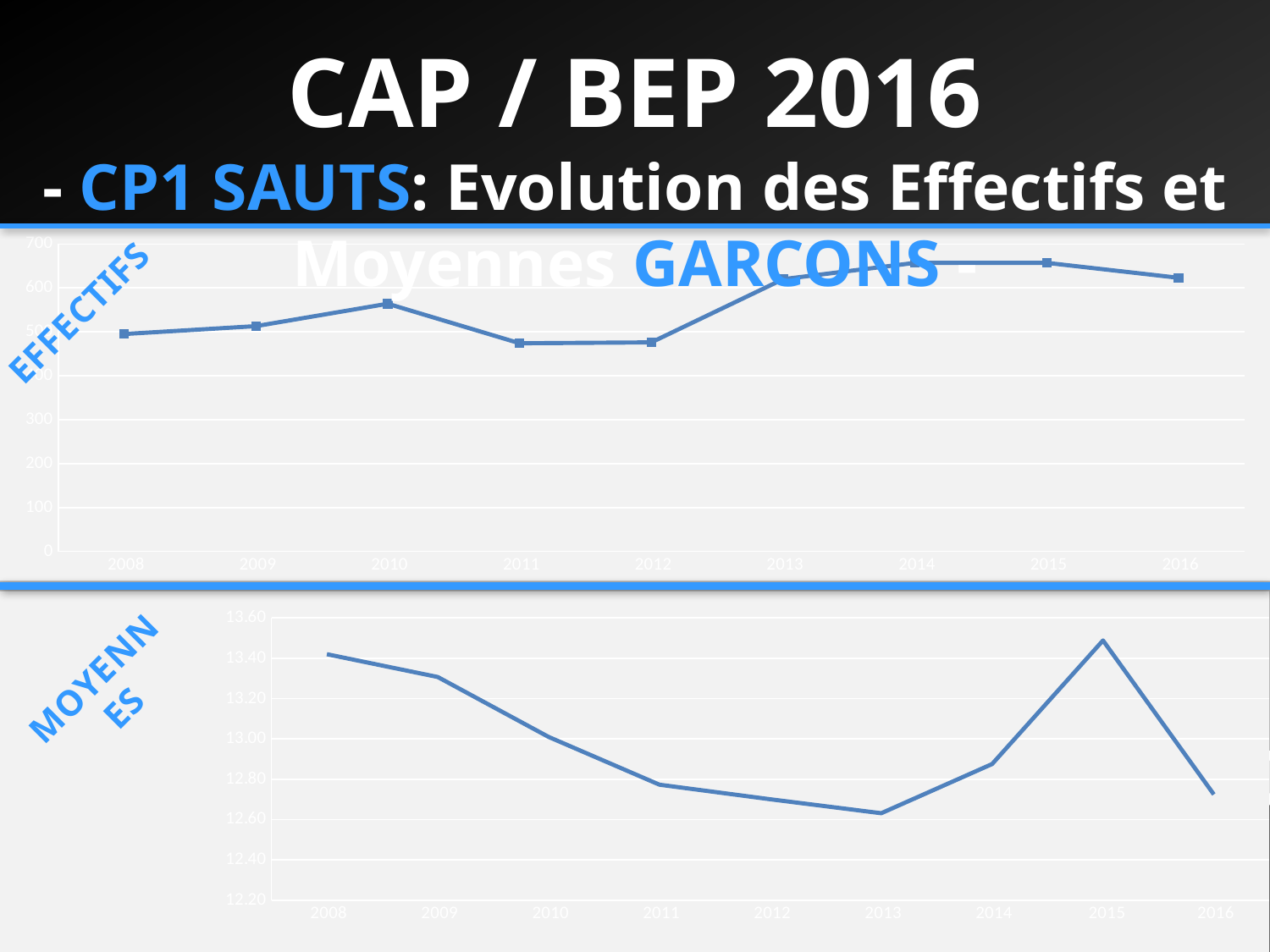
On the top chart (EFFECTIFS), is the value for 2011 greater or less than 500? less On the bottom chart (MOYENNES), is the value for 2013 greater or less than 12.80? less On the bottom chart (MOYENNES), do the values rise or fall from 2008 to 2013? fall How many years are plotted on the bottom chart (MOYENNES)? 9 On the top chart (EFFECTIFS), which is larger, the value for 2014 or the value for 2011? 2014 On the top chart (EFFECTIFS), is the value for 2010 greater or less than 500? greater How many years are plotted on the top chart (EFFECTIFS)? 9 On the bottom chart (MOYENNES), which is larger, the value for 2008 or the value for 2013? 2008 What kind of chart is the top chart (EFFECTIFS)? line chart What kind of chart is the bottom chart (MOYENNES)? line chart On the top chart (EFFECTIFS), do the values rise or fall from 2012 to 2014? rise